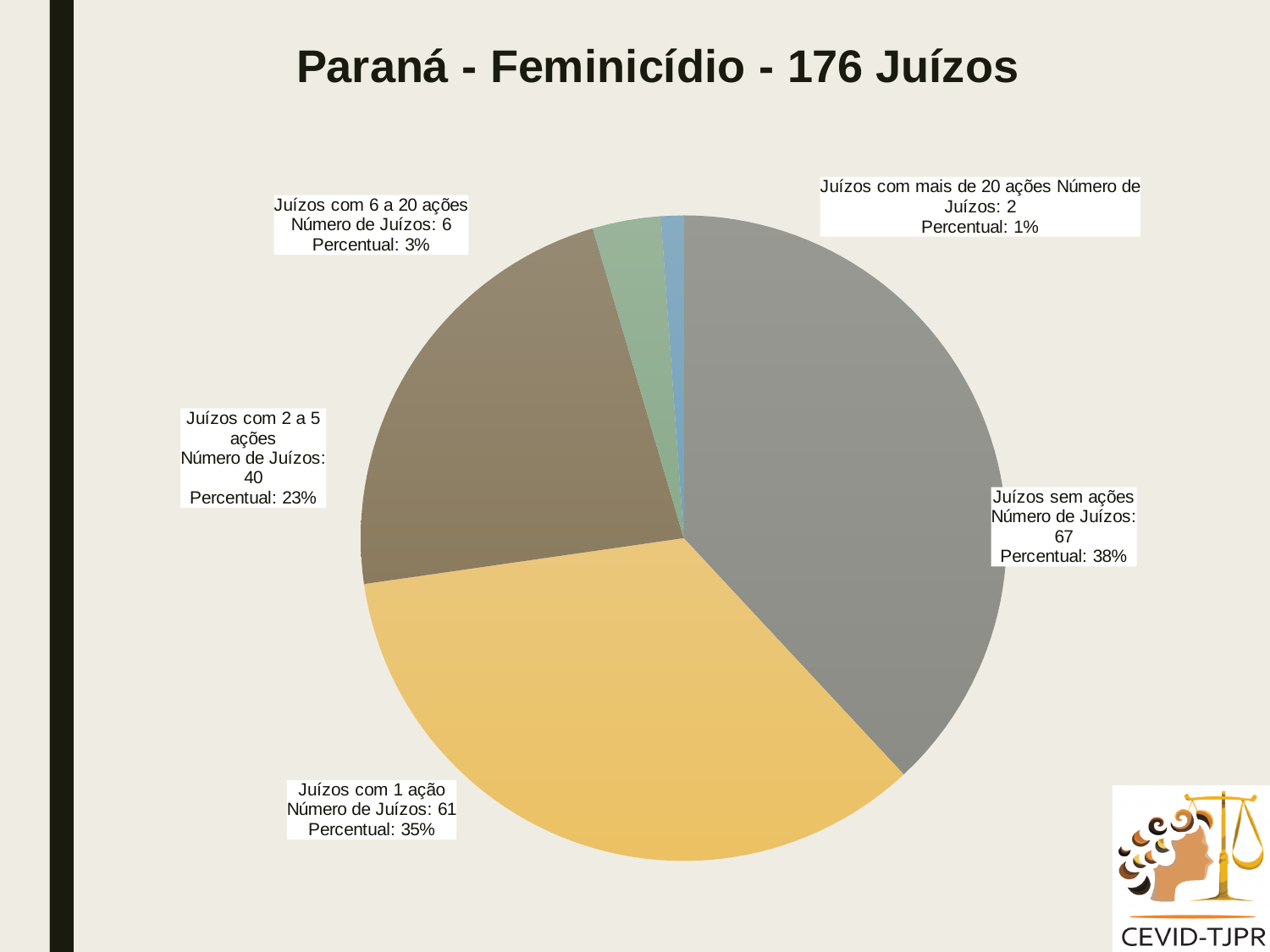
What percentage of the pie is 'Juízos com 1 ação'? 35% Which category has the largest slice of the pie? Juízos sem ações What is the number of Juízos for 'Juízos sem ações'? 67 What is the title of the chart? Paraná - Feminicídio - 176 Juízos What is the number of Juízos for 'Juízos com 2 a 5 ações'? 40 What is the number of Juízos for 'Juízos com mais de 20 ações'? 2 How many slices does the pie chart have? 5 What is the difference in number of Juízos between 'Juízos sem ações' and 'Juízos com 1 ação'? 6 Which has more Juízos: 'Juízos com 2 a 5 ações' or 'Juízos com 6 a 20 ações'? Juízos com 2 a 5 ações Which category has the smallest slice of the pie? Juízos com mais de 20 ações What percentage is shown for 'Juízos com 6 a 20 ações'? 3% What kind of chart is shown on the slide? pie chart